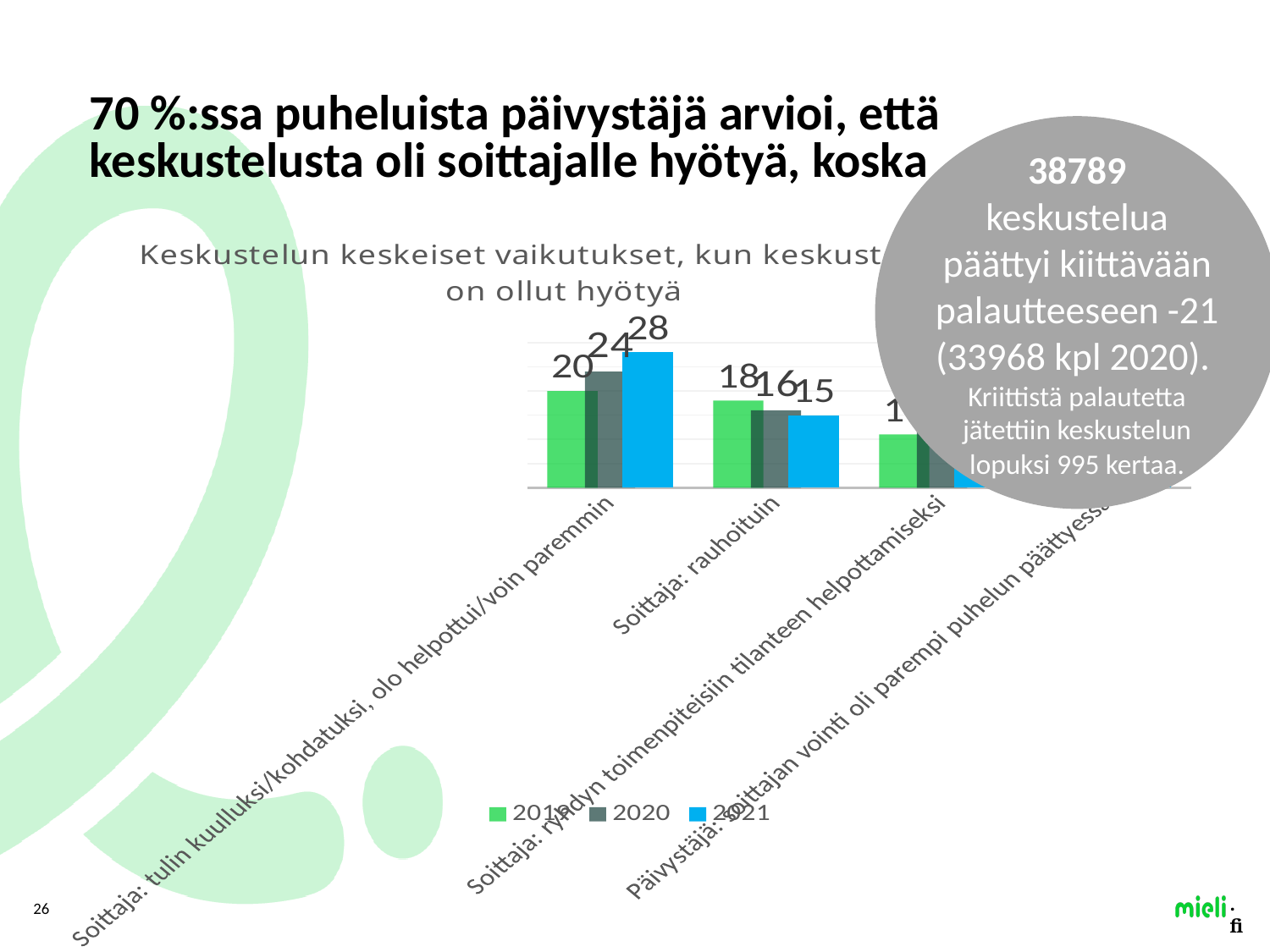
Do the values for 'Soittaja: tulin kuulluksi/kohdatuksi, olo helpottui/voin paremmin' rise or fall from 2019 to 2021? rise What is the difference between the 2019 and 2021 values for 'Soittaja: rauhoituin'? 3 What is the 2021 value for 'Soittaja: tulin kuulluksi/kohdatuksi, olo helpottui/voin paremmin'? 28 Do the values for 'Soittaja: rauhoituin' rise or fall from 2019 to 2021? fall How many series does the legend list? 3 Which years are listed in the chart legend? 2019, 2020, 2021 What is the 2019 value for 'Soittaja: rauhoituin'? 18 Which is larger for 2020: 'Soittaja: tulin kuulluksi/kohdatuksi, olo helpottui/voin paremmin' or 'Soittaja: rauhoituin'? Soittaja: tulin kuulluksi/kohdatuksi, olo helpottui/voin paremmin What is the difference between the 2021 and 2019 values for 'Soittaja: tulin kuulluksi/kohdatuksi, olo helpottui/voin paremmin'? 8 What is the 2021 value for 'Soittaja: rauhoituin'? 15 What kind of chart is shown on the slide? bar chart What is the 2020 value for 'Soittaja: tulin kuulluksi/kohdatuksi, olo helpottui/voin paremmin'? 24